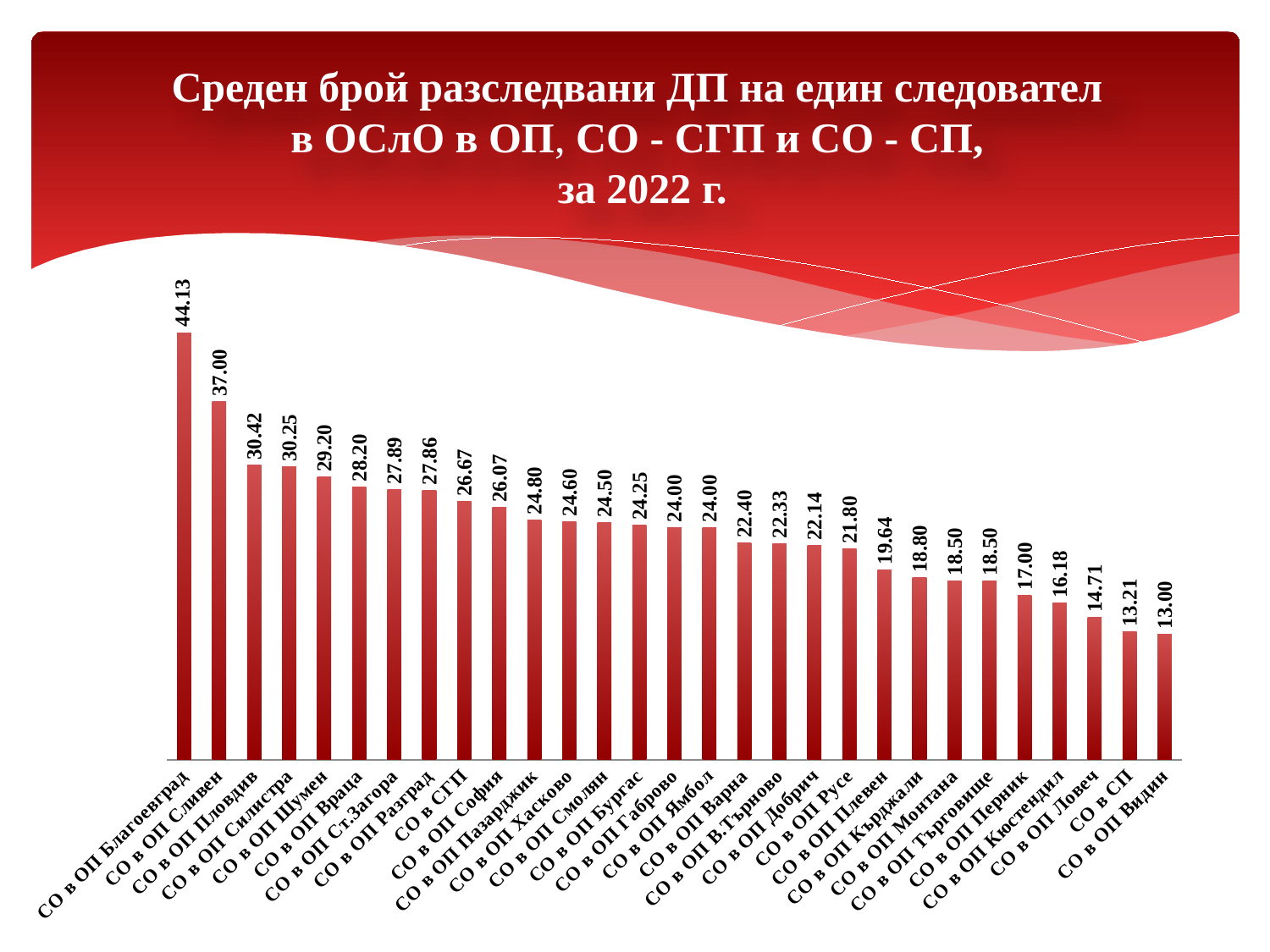
Do the values rise or fall from left to right along the x axis? Fall What is the difference between the values for СО в ОП Варна and СО в ОП Русе? 0.60 Which category has the lowest value? СО в ОП Видин Which category has the highest value? СО в ОП Благоевград What is the value for СО в СП? 13.21 What is the value for СО в СГП? 26.67 Which is larger, the value for СО в ОП Шумен or the value for СО в ОП Враца? СО в ОП Шумен What is the value for СО в ОП Плевен? 19.64 What is the difference between the values for СО в ОП Благоевград and СО в ОП Сливен? 7.13 What kind of chart is shown on the slide? Bar chart How many categories are shown in the chart? 29 What is the value for СО в ОП Благоевград? 44.13